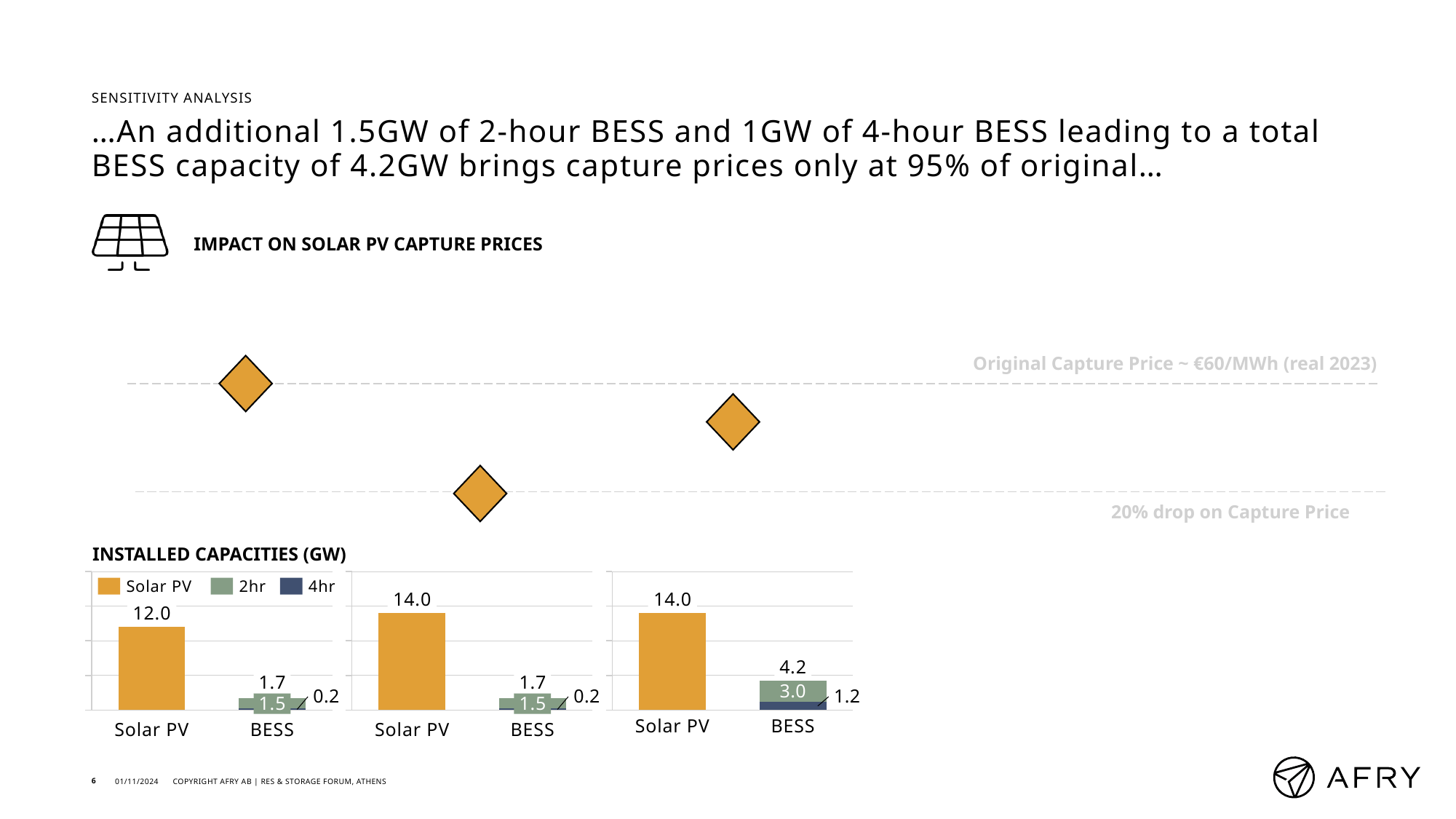
In the middle installed capacities chart, what is the value for Solar PV? 14.0 In the left installed capacities chart, what is the total of the BESS stacked bar? 1.7 In the middle installed capacities chart, which category is higher, Solar PV or BESS? Solar PV In the left installed capacities chart, what is the difference between Solar PV and the BESS total? 10.3 In the right installed capacities chart, what is the 2hr value for BESS? 3.0 What kind of chart is used for the installed capacities? Stacked bar chart In the right installed capacities chart, what is the difference between the 2hr and 4hr BESS values? 1.8 In the right installed capacities chart, what is the total of the BESS stacked bar? 4.2 How many series does the legend of the installed capacities charts list? 3 In the left installed capacities chart, what is the value for Solar PV? 12.0 In the capture price chart above the bar charts, which of the three diamond markers is the lowest? The middle one In the right installed capacities chart, what is the 4hr value for BESS? 1.2